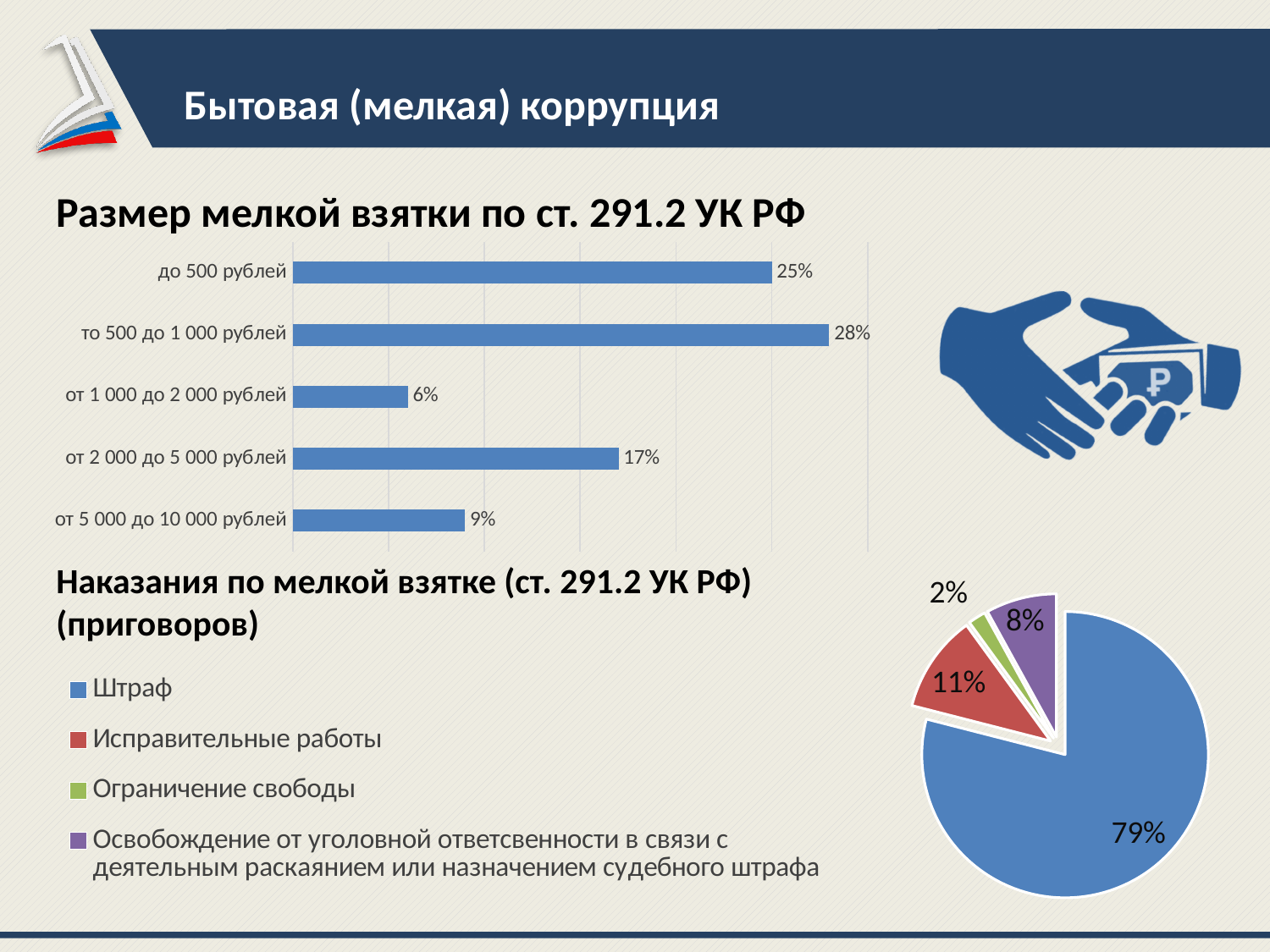
What kind of chart is 'Размер мелкой взятки по ст. 291.2 УК РФ'? Bar chart In the bar chart 'Размер мелкой взятки по ст. 291.2 УК РФ', what is the difference between the values for 'то 500 до 1 000 рублей' and 'от 5 000 до 10 000 рублей'? 19% In the bar chart 'Размер мелкой взятки по ст. 291.2 УК РФ', what is the value for 'до 500 рублей'? 25% In the pie chart 'Наказания по мелкой взятке (ст. 291.2 УК РФ) (приговоров)', which category has the smallest slice? Ограничение свободы In the pie chart 'Наказания по мелкой взятке (ст. 291.2 УК РФ) (приговоров)', what share does 'Штраф' have? 79% In the bar chart 'Размер мелкой взятки по ст. 291.2 УК РФ', which is larger: the value for 'до 500 рублей' or for 'от 2 000 до 5 000 рублей'? до 500 рублей In the bar chart 'Размер мелкой взятки по ст. 291.2 УК РФ', which category has the lowest value? от 1 000 до 2 000 рублей How many categories does the bar chart 'Размер мелкой взятки по ст. 291.2 УК РФ' show? 5 How many entries does the legend of the pie chart 'Наказания по мелкой взятке (ст. 291.2 УК РФ) (приговоров)' list? 4 In the bar chart 'Размер мелкой взятки по ст. 291.2 УК РФ', which category has the highest value? то 500 до 1 000 рублей In the bar chart 'Размер мелкой взятки по ст. 291.2 УК РФ', what is the value for 'от 2 000 до 5 000 рублей'? 17% In the pie chart 'Наказания по мелкой взятке (ст. 291.2 УК РФ) (приговоров)', what share does 'Исправительные работы' have? 11%